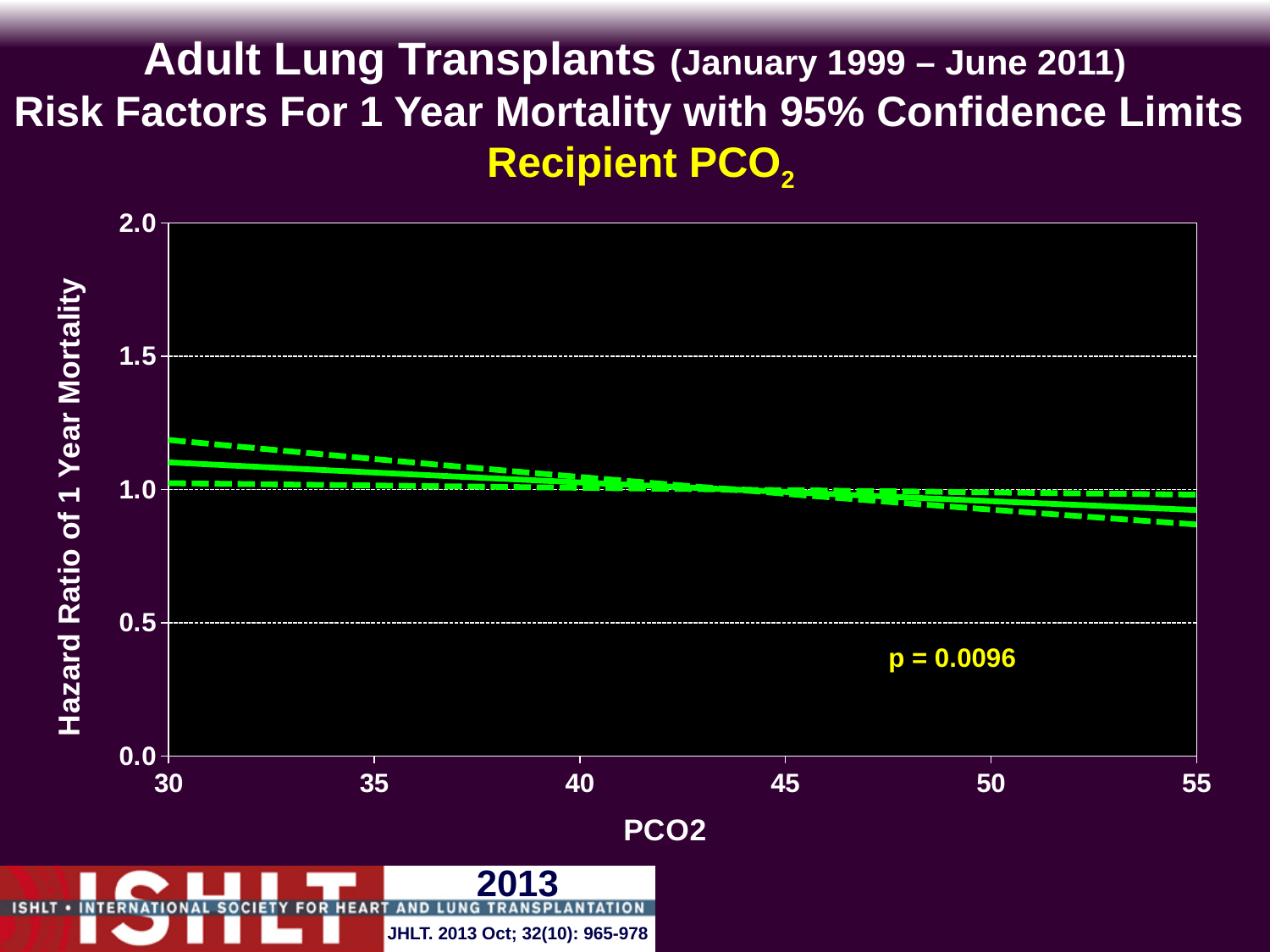
How many lines are plotted on the chart (the estimate plus its confidence limits)? 3 What is the label of the y axis? Hazard Ratio of 1 Year Mortality How many tick labels are shown on the x axis? 6 What kind of chart is shown on the slide? line chart Is the hazard ratio (solid line) at a PCO2 of 30 greater or less than 1.0? greater Which has the larger hazard ratio on the solid line: a PCO2 of 30 or a PCO2 of 55? 30 Does the hazard ratio of 1 year mortality rise or fall as recipient PCO2 increases from 30 to 55? fall Is the hazard ratio (solid line) at a PCO2 of 55 greater or less than 1.0? less What is the label of the x axis? PCO2 Is the lower 95% confidence limit at a PCO2 of 55 greater or less than 0.5? greater What p-value is printed on the chart? p = 0.0096